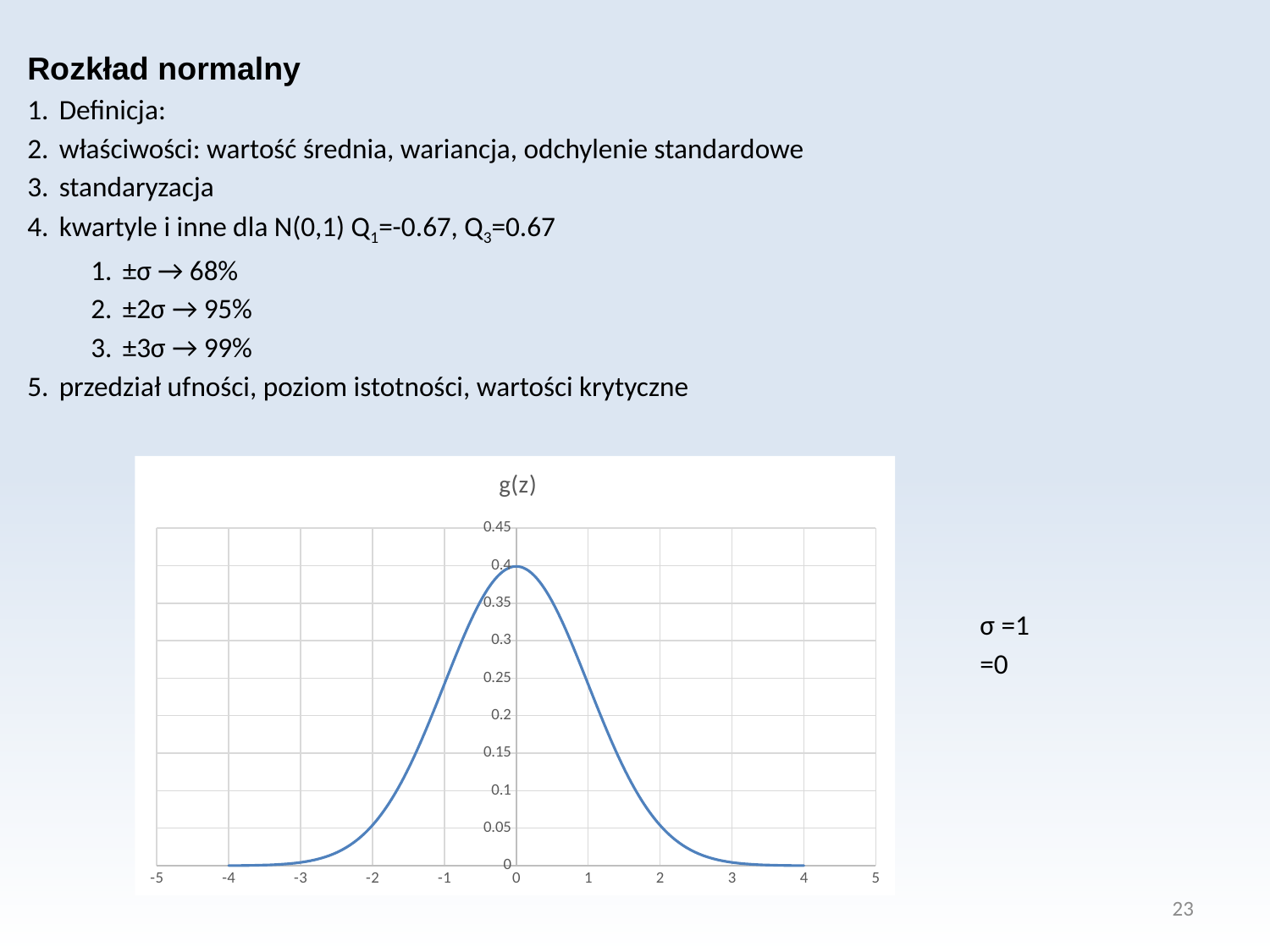
Does the curve g(z) rise or fall as z goes from 0 to 4? fall Does the curve g(z) rise or fall as z goes from -4 to 0? rise What kind of chart is shown on the slide? line chart Is the value of g(z) at z = 1 greater or less than 0.3? less What is the title of the chart on the slide? g(z) Is the value of g(z) at z = -1 greater or less than 0.2? greater At which value of z does the curve g(z) reach its highest point? 0 Is the value of g(z) at z = 3 greater or less than 0.05? less What is the highest tick value shown on the vertical axis of the chart? 0.45 Which is larger, the value of g(z) at z = 1 or at z = 2? z = 1